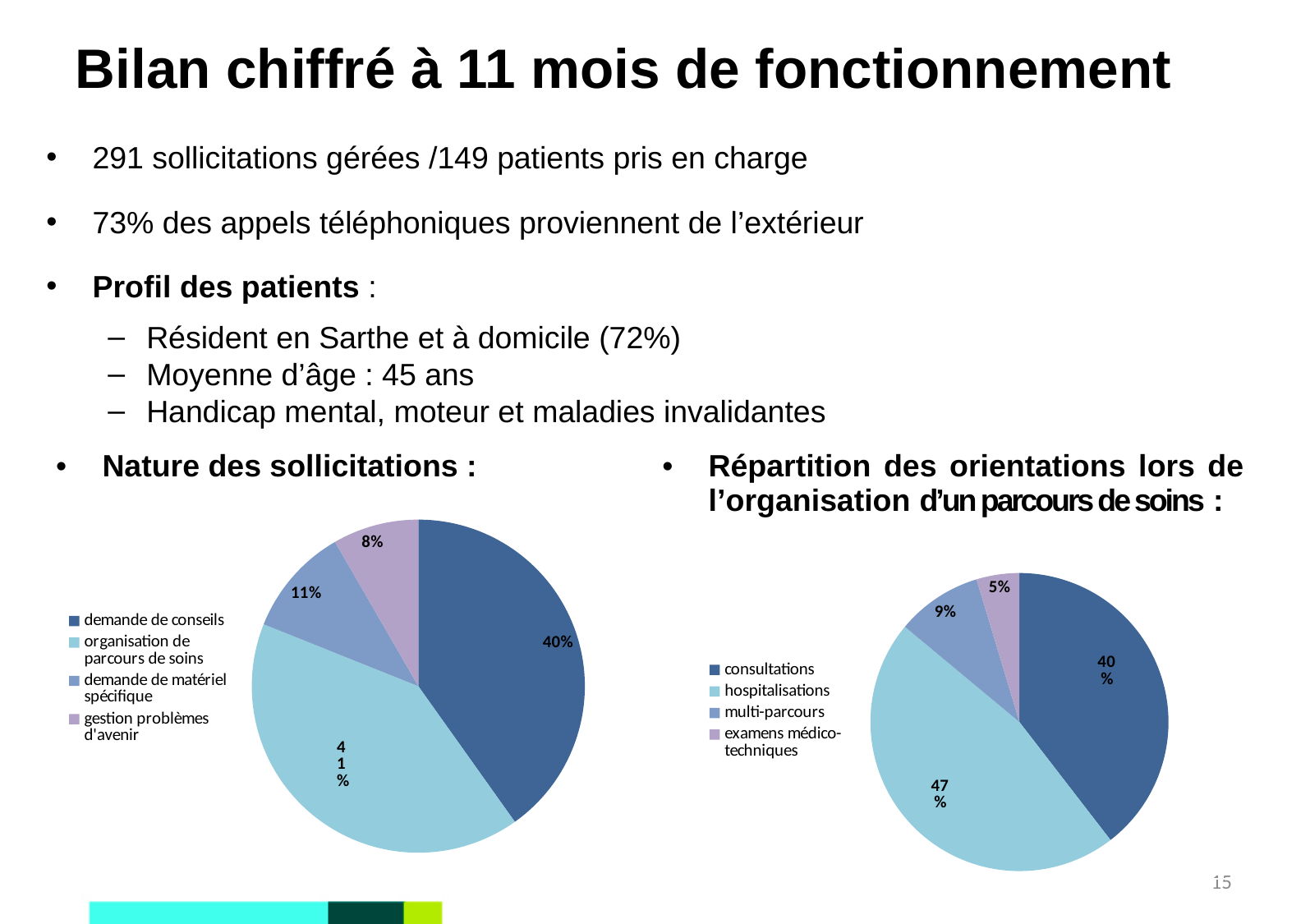
In the 'Nature des sollicitations' pie chart, what share is 'demande de conseils'? 40% In the 'Répartition des orientations' pie chart, what share is 'hospitalisations'? 47% In the 'Répartition des orientations' pie chart, which is larger: 'multi-parcours' or 'examens médico-techniques'? multi-parcours In the 'Répartition des orientations' pie chart, which category has the smallest share? examens médico-techniques In the 'Nature des sollicitations' pie chart, which category has the smallest share? gestion problèmes d'avenir In the 'Répartition des orientations' pie chart, which category has the largest share? hospitalisations In the 'Nature des sollicitations' pie chart, what share is 'demande de matériel spécifique'? 11% What type of chart is used for 'Nature des sollicitations'? pie chart In the 'Nature des sollicitations' pie chart, what share is 'organisation de parcours de soins'? 41% In the 'Répartition des orientations' pie chart, what share is 'examens médico-techniques'? 5% In the 'Répartition des orientations' pie chart, what is the difference between the shares of 'hospitalisations' and 'consultations'? 7% In the 'Nature des sollicitations' pie chart, how many categories does the legend list? 4